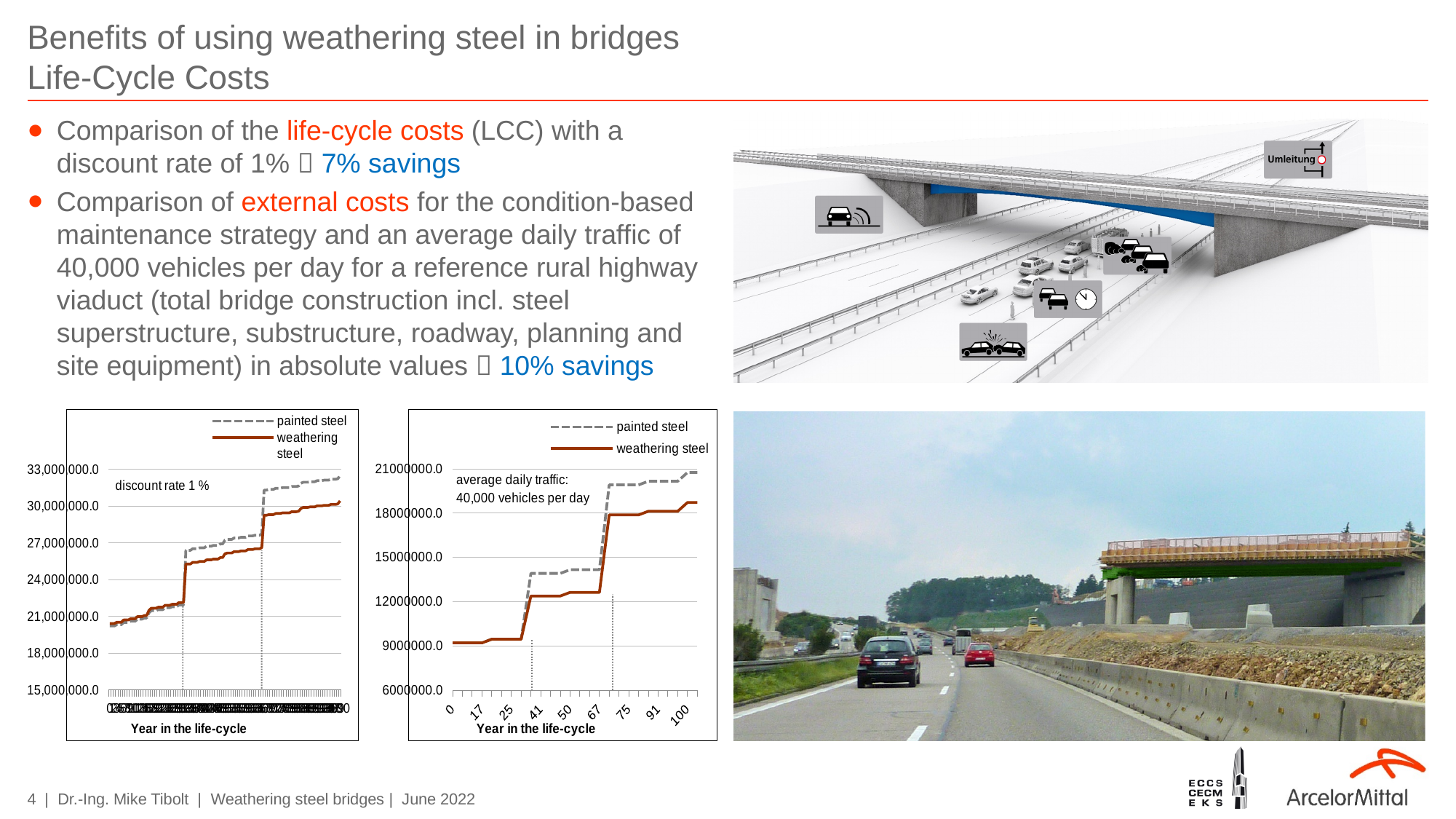
In the left chart (discount rate 1 %), which series ends at the higher value, painted steel or weathering steel? painted steel In the right chart (average daily traffic: 40,000 vehicles per day), is the value for painted steel at year 0 greater or less than 12000000.0? less In the right chart (average daily traffic: 40,000 vehicles per day), which series is higher at year 100, painted steel or weathering steel? painted steel In the right chart (average daily traffic: 40,000 vehicles per day), is the value for weathering steel at year 100 greater or less than 18000000.0? greater In the left chart (discount rate 1 %), is the value for painted steel at the start of the life-cycle greater or less than 24,000,000.0? less In the right chart (average daily traffic: 40,000 vehicles per day), what is the x-axis title? Year in the life-cycle In the left chart (discount rate 1 %), how many series does the legend list? 2 In the left chart (discount rate 1 %), which series is drawn with a dashed line? painted steel In the left chart (discount rate 1 %), do the values for painted steel rise or fall along the x axis? rise In the right chart (average daily traffic: 40,000 vehicles per day), do the values for weathering steel rise or fall along the x axis? rise In the right chart (average daily traffic: 40,000 vehicles per day), what kind of chart is shown? line chart